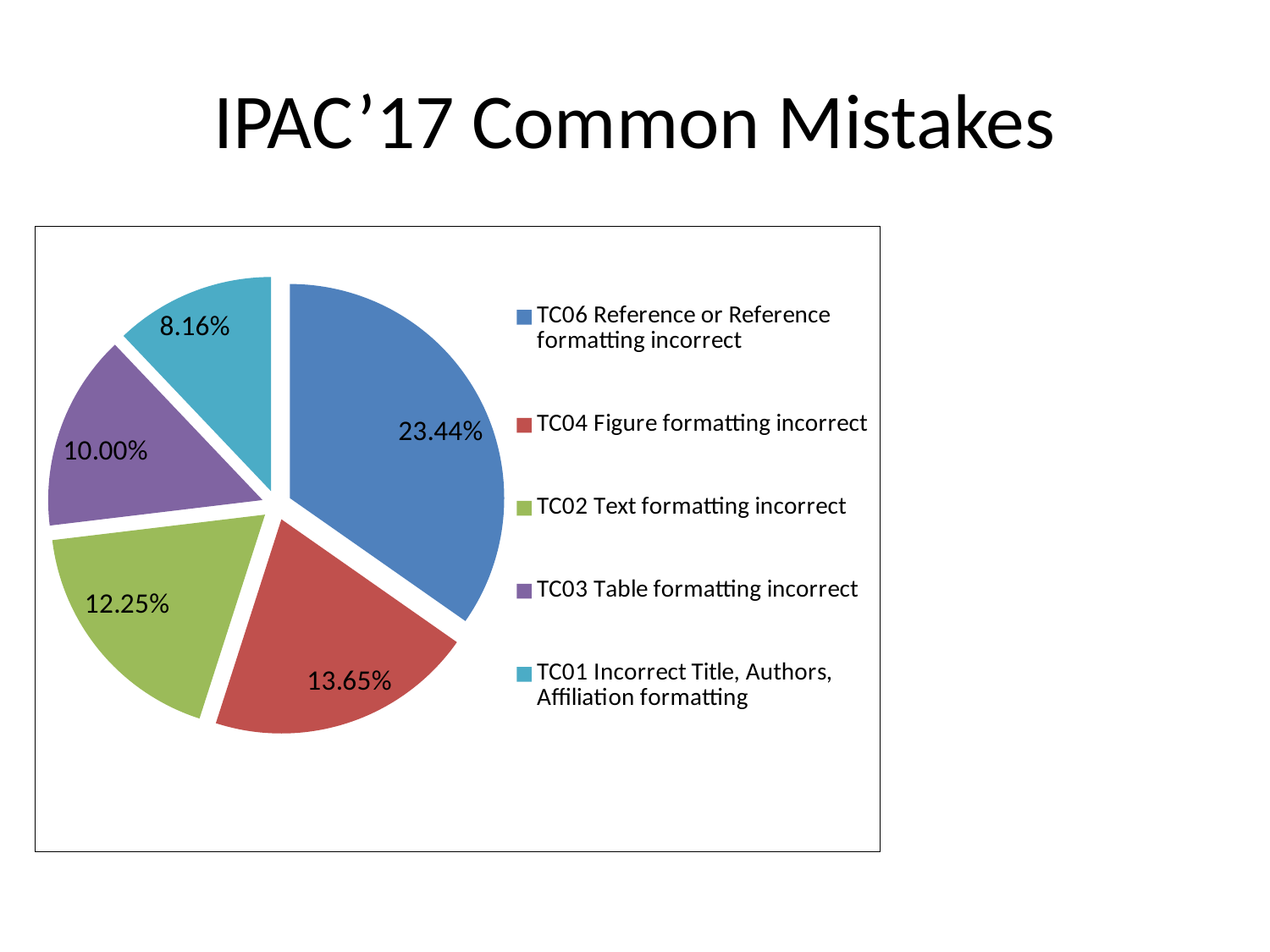
How many categories does the pie chart show? 5 What is the value labelled on the slice for TC01 Incorrect Title, Authors, Affiliation formatting? 8.16% What is the difference between the labelled values for TC06 Reference or Reference formatting incorrect and TC04 Figure formatting incorrect? 9.79% What is the value labelled on the slice for TC03 Table formatting incorrect? 10.00% What is the value labelled on the slice for TC06 Reference or Reference formatting incorrect? 23.44% Which category has the largest slice of the pie? TC06 Reference or Reference formatting incorrect What is the title of the slide containing the pie chart? IPAC'17 Common Mistakes What is the value labelled on the slice for TC04 Figure formatting incorrect? 13.65% What kind of chart is shown on the slide? Pie chart Which category has the smallest slice of the pie? TC01 Incorrect Title, Authors, Affiliation formatting Which has the larger labelled value, TC02 Text formatting incorrect or TC03 Table formatting incorrect? TC02 Text formatting incorrect What is the value labelled on the slice for TC02 Text formatting incorrect? 12.25%